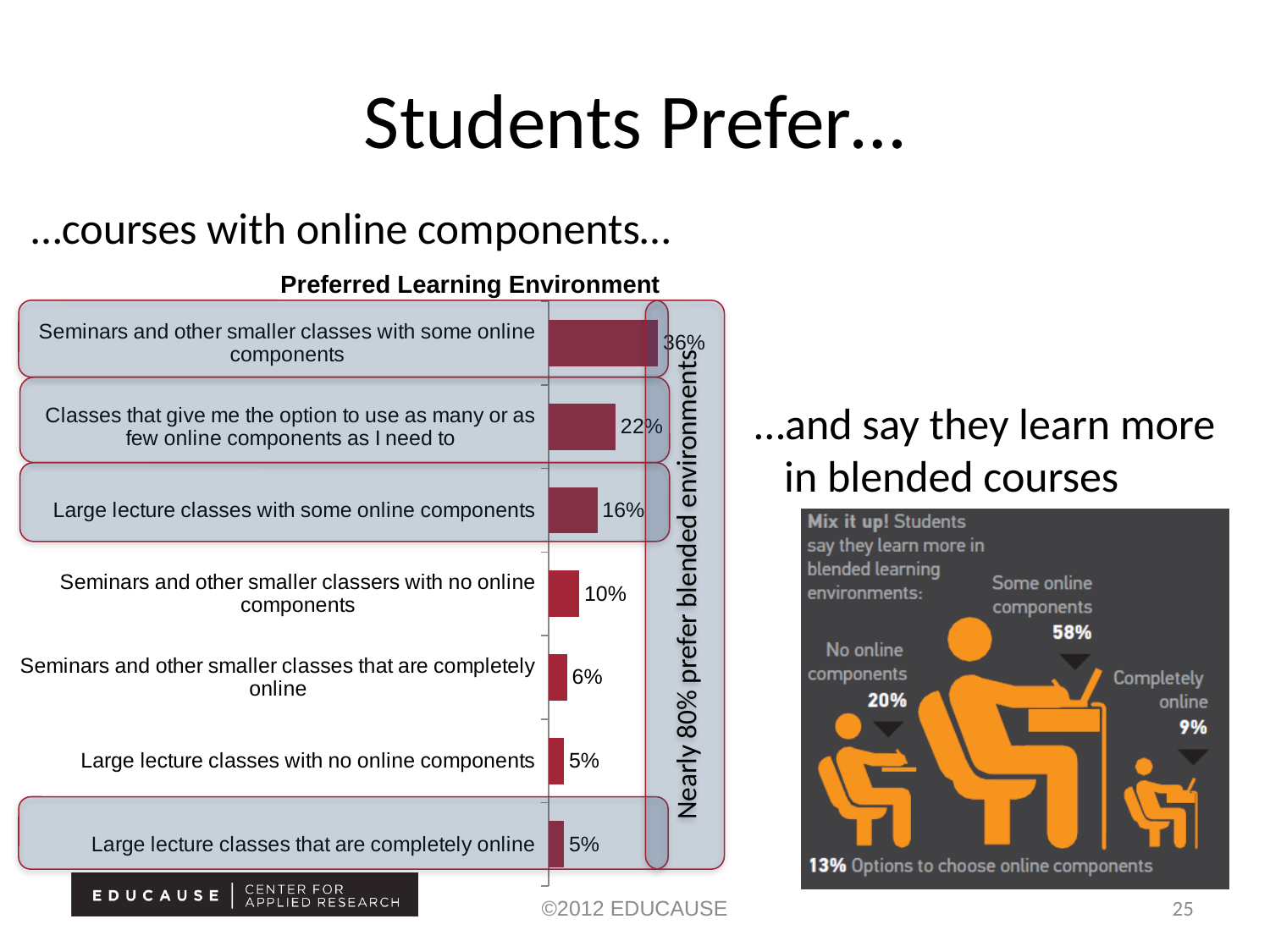
In the "Preferred Learning Environment" chart, what is the value for seminars and other smaller classes that are completely online? 6% In the "Preferred Learning Environment" chart, what is the value for large lecture classes with some online components? 16% What does the vertical text label beside the bars in the "Preferred Learning Environment" chart say? Nearly 80% prefer blended environments In the "Preferred Learning Environment" chart, what is the combined value of the three highlighted categories with some or optional online components (36%, 22% and 16%)? 74% Which category has the highest value in the "Preferred Learning Environment" chart? Seminars and other smaller classes with some online components In the "Preferred Learning Environment" chart, what is the difference between the value for seminars and other smaller classes with some online components and the value for large lecture classes with some online components? 20% How many categories are shown in the "Preferred Learning Environment" chart? 7 In the "Preferred Learning Environment" chart, what is the value for classes that give me the option to use as many or as few online components as I need to? 22% What kind of chart is the "Preferred Learning Environment" chart? bar chart In the "Preferred Learning Environment" chart, which is larger: the value for seminars and other smaller classers with no online components or the value for large lecture classes with no online components? Seminars and other smaller classers with no online components In the "Preferred Learning Environment" chart, what percentage of students prefer seminars and other smaller classes with some online components? 36% What is the title of the bar chart on the slide? Preferred Learning Environment